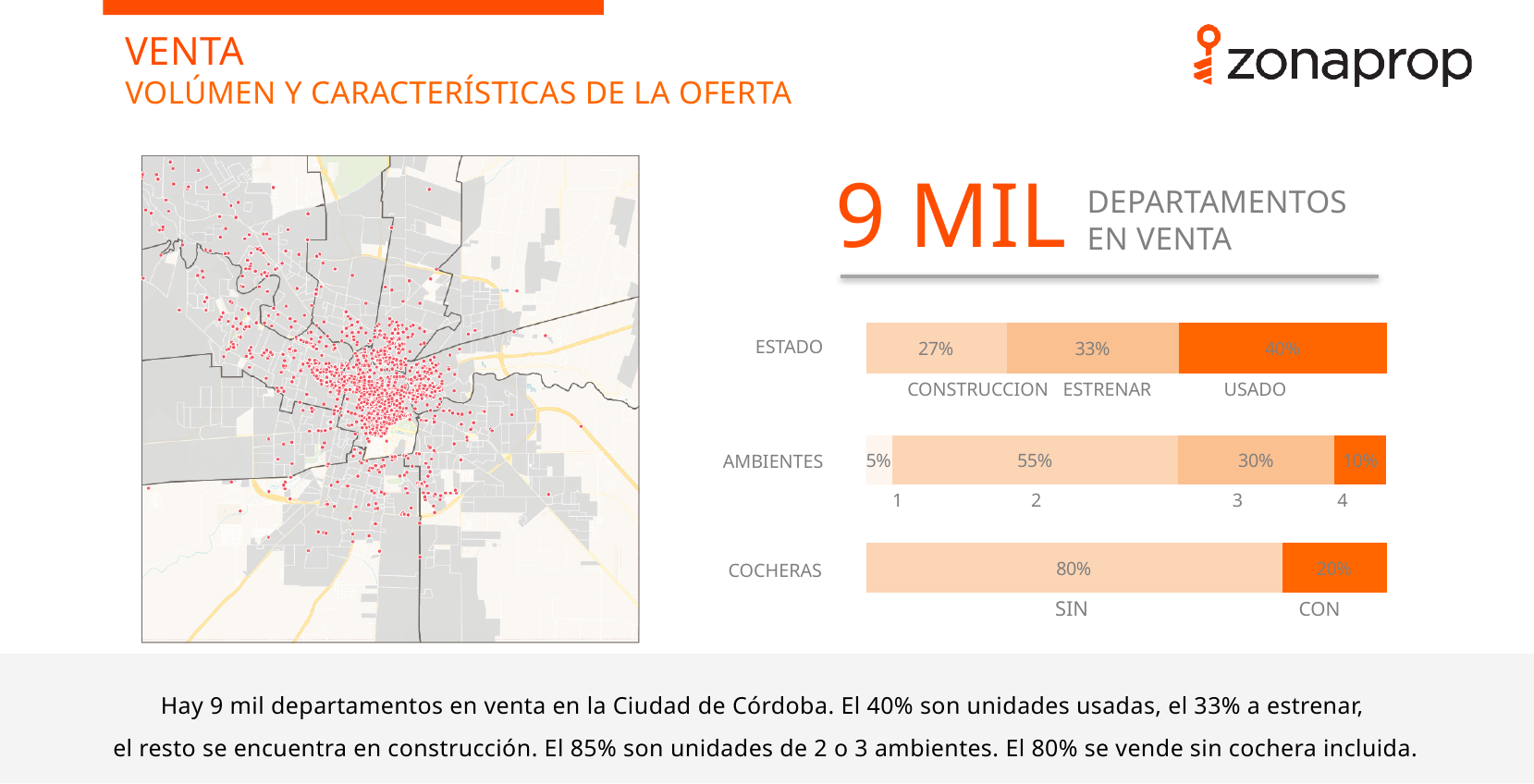
In the COCHERAS bar, what percentage of apartments are sold SIN cochera? 80% In the COCHERAS bar, which is larger, SIN or CON? SIN In the ESTADO bar, which category has the largest share? USADO In the ESTADO bar, what percentage of apartments for sale are in CONSTRUCCION? 27% In the ESTADO bar, what percentage of apartments for sale are USADO? 40% In the AMBIENTES bar, which number of ambientes has the smallest share? 1 In the ESTADO bar, what is the difference between the ESTRENAR and CONSTRUCCION shares? 6% In the AMBIENTES bar, what percentage of apartments have 2 ambientes? 55% What kind of chart is used to show ESTADO, AMBIENTES and COCHERAS? Stacked bar chart In the AMBIENTES bar, what is the combined share of apartments with 2 or 3 ambientes? 85% How many apartments for sale does the slide report in total? 9 MIL In the AMBIENTES bar, how many categories are shown? 4